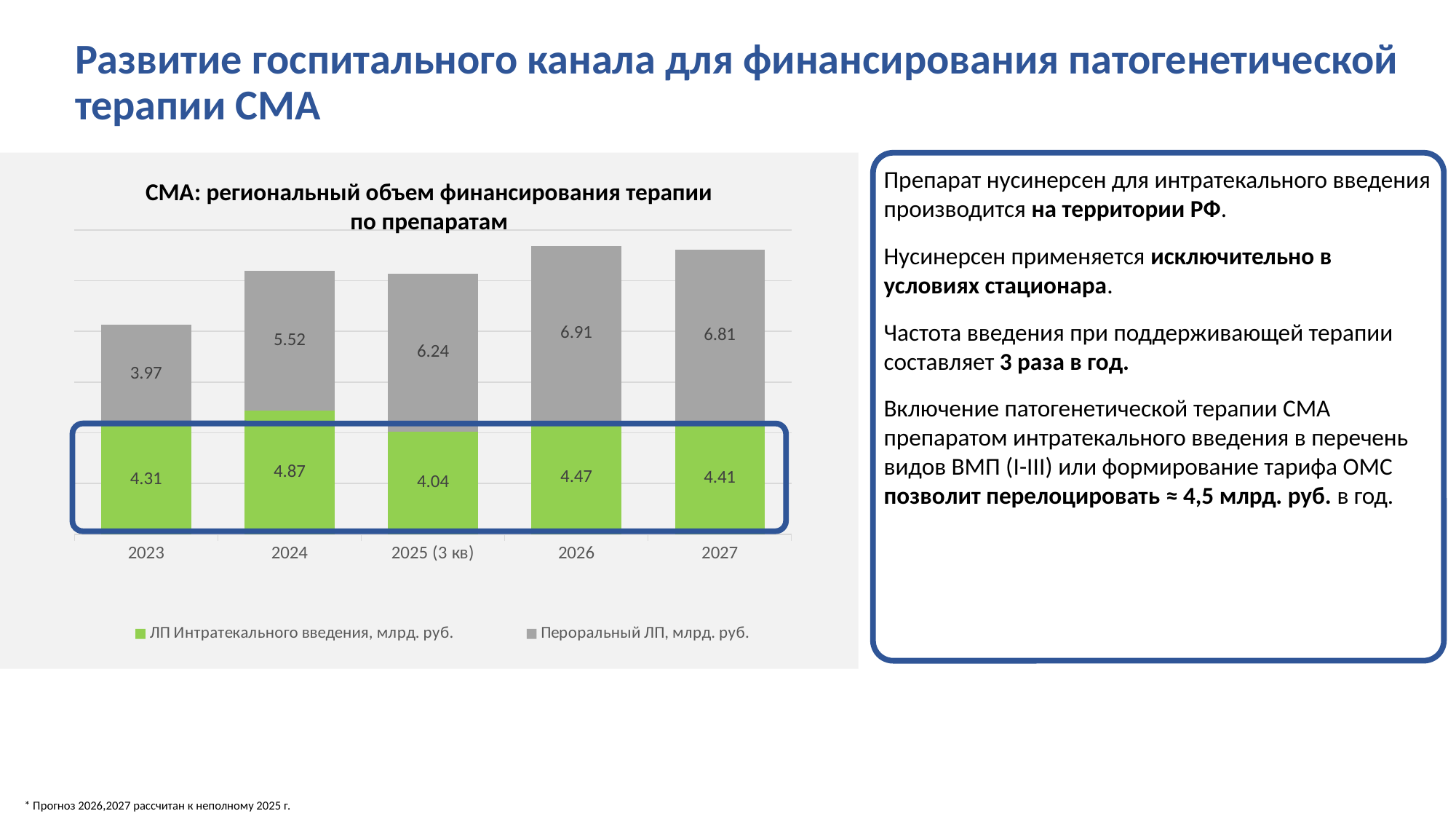
What is the value for Пероральный ЛП in 2026? 6.91 In which year is the value for Пероральный ЛП the highest? 2026 How many categories (years) are shown on the x axis of the chart? 5 What is the total of the stacked bar for 2026? 11.38 What is the difference between the Пероральный ЛП values for 2027 and 2023? 2.84 What type of chart is shown on the slide? Stacked bar chart How many series does the chart legend list? 2 What is the value for ЛП Интратекального введения in 2024? 4.87 In which year is the value for ЛП Интратекального введения the lowest? 2025 (3 кв) What is the value for Пероральный ЛП in 2023? 3.97 What is the title of the chart? СМА: региональный объем финансирования терапии по препаратам Which is larger in 2025 (3 кв): ЛП Интратекального введения or Пероральный ЛП? Пероральный ЛП